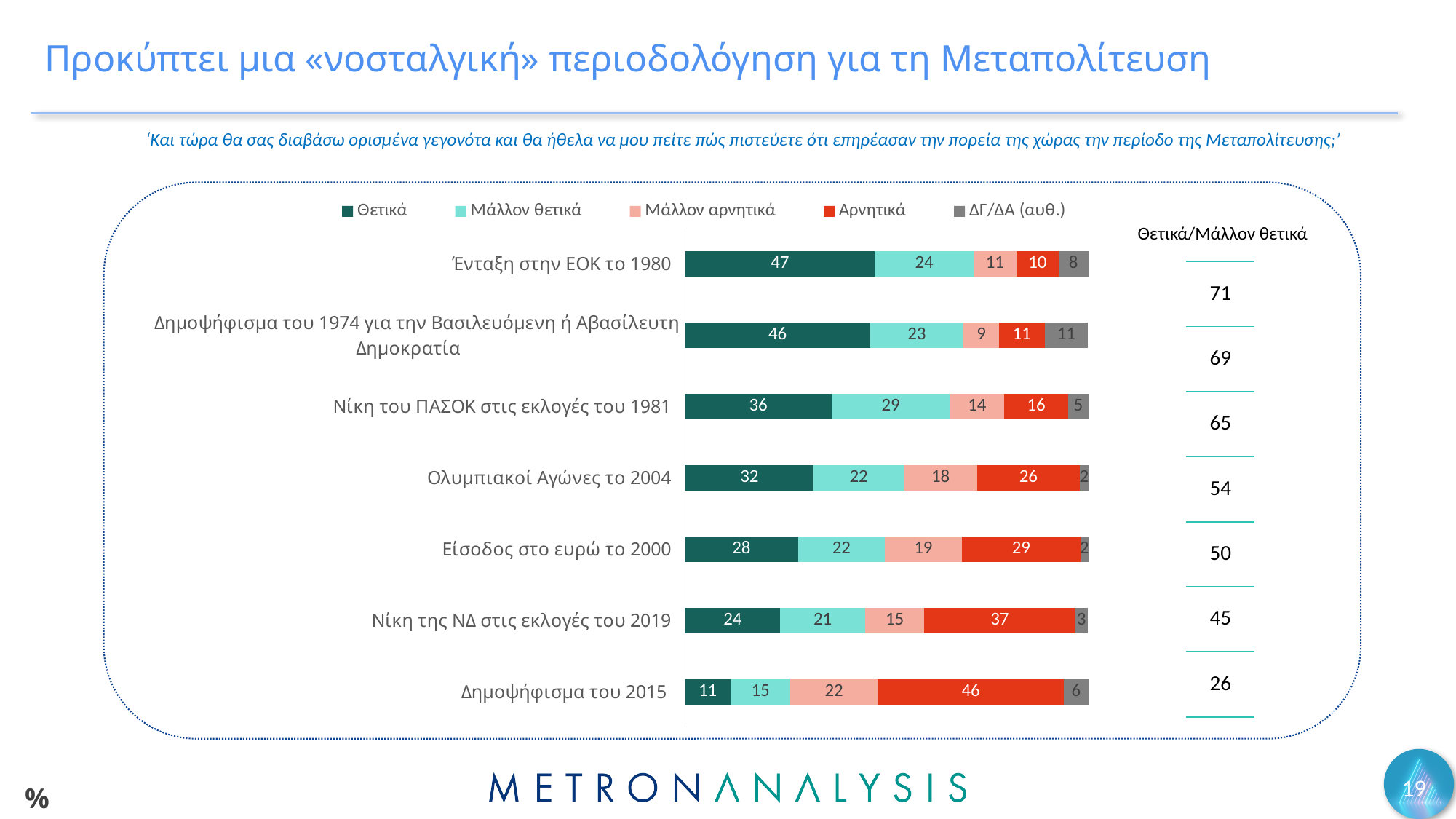
What is the Αρνητικά value for Δημοψήφισμα του 2015? 46 What type of chart is shown on the slide? stacked bar chart Which event has the lowest Θετικά value? Δημοψήφισμα του 2015 What is the ΔΓ/ΔΑ (αυθ.) value for Δημοψήφισμα του 1974 για την Βασιλευόμενη ή Αβασίλευτη Δημοκρατία? 11 How many series does the legend list? 5 What is the Θετικά/Μάλλον θετικά combined figure shown for Είσοδος στο ευρώ το 2000? 50 Which is larger: the Μάλλον αρνητικά value for Είσοδος στο ευρώ το 2000 or for Ολυμπιακοί Αγώνες το 2004? Είσοδος στο ευρώ το 2000 What is the Θετικά value for Ένταξη στην ΕΟΚ το 1980? 47 What is the difference between the Αρνητικά values for Νίκη της ΝΔ στις εκλογές του 2019 and Ολυμπιακοί Αγώνες το 2004? 11 How many events (categories) are plotted in the chart? 7 Which event has the highest Θετικά value? Ένταξη στην ΕΟΚ το 1980 What is the Μάλλον θετικά value for Νίκη του ΠΑΣΟΚ στις εκλογές του 1981? 29